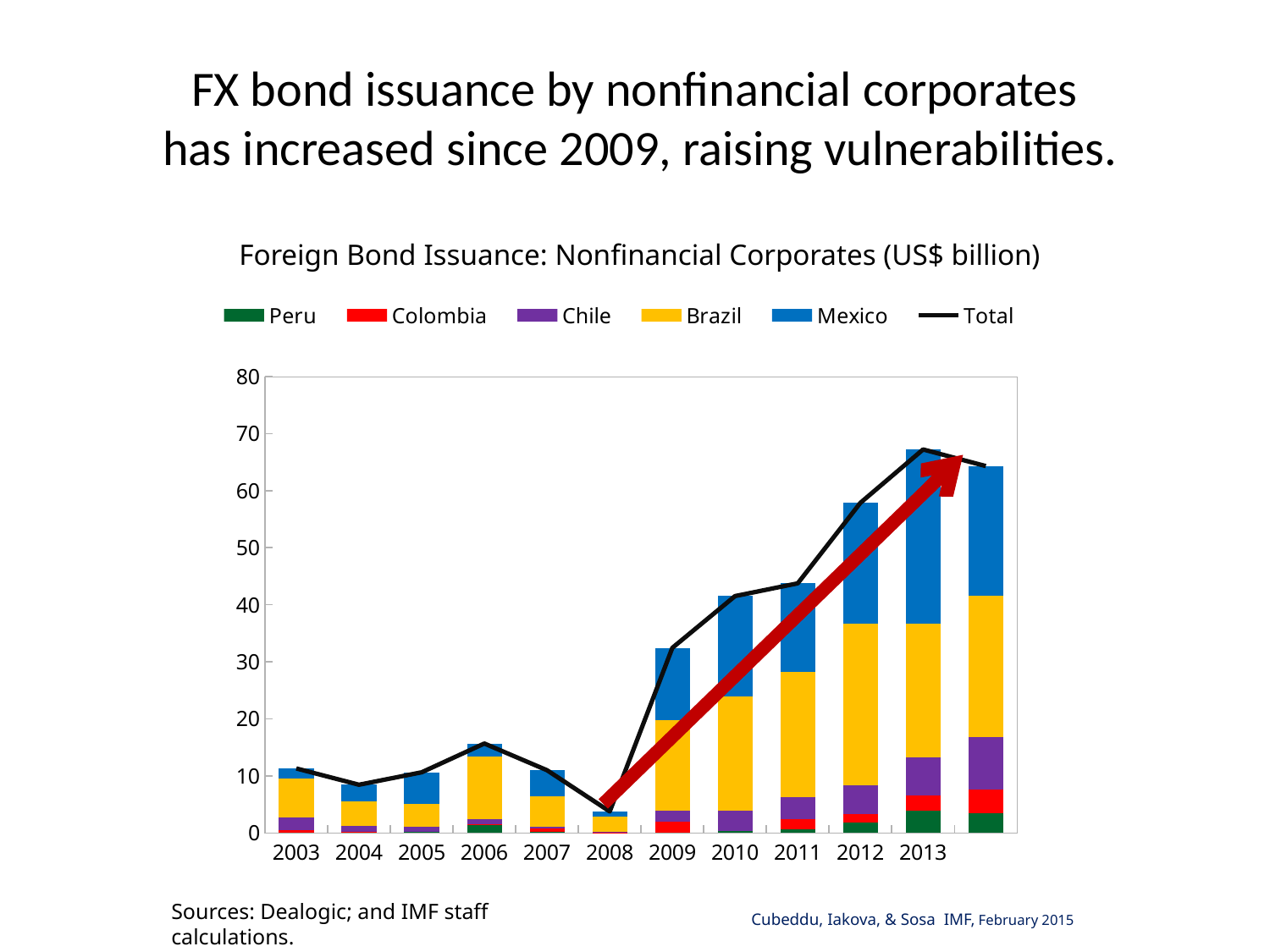
Is the total for 2013 greater or less than 60? greater Is the total for 2004 greater or less than 10? less Which labeled year has the lowest total foreign bond issuance? 2008 What kind of chart is shown on the slide? stacked bar chart with a line Is the total for 2008 greater or less than 10? less How many years are labeled on the x axis? 11 Which year has a larger total, 2009 or 2012? 2012 Which labeled year has the highest total foreign bond issuance? 2013 Which country is shown in yellow in the legend? Brazil How many series does the legend list? 6 Does the total rise or fall from 2008 to 2013? rise